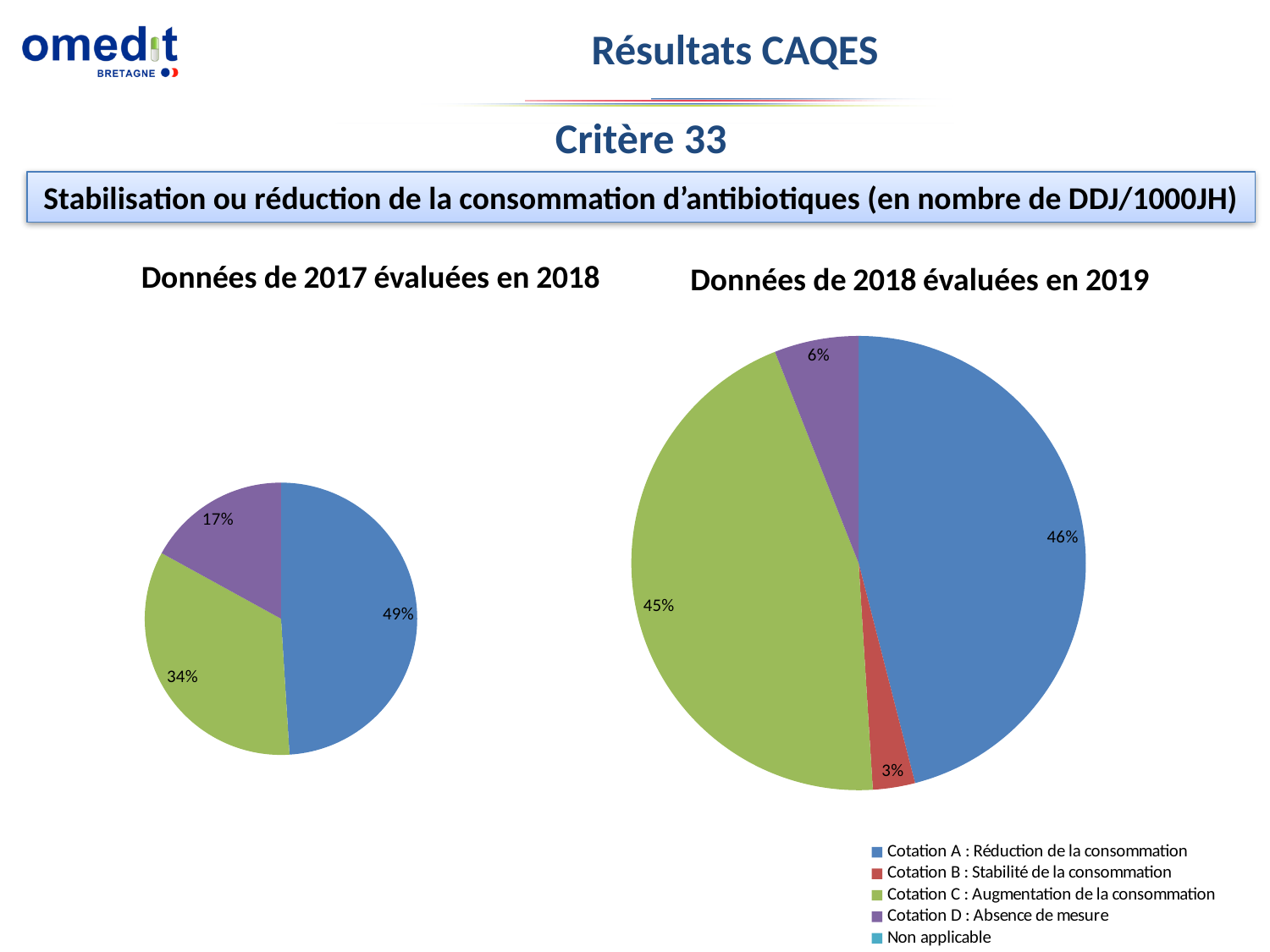
In the chart titled "Données de 2017 évaluées en 2018", what is the difference between the shares for Cotation A and Cotation C? 15% In the chart titled "Données de 2017 évaluées en 2018", which category has the smallest slice? Cotation D : Absence de mesure Which chart shows a larger share for Cotation D : Absence de mesure, the 2017 data chart or the 2018 data chart? Données de 2017 évaluées en 2018 In the chart titled "Données de 2017 évaluées en 2018", what share is shown for Cotation A : Réduction de la consommation? 49% How many entries does the legend list? 5 In the chart titled "Données de 2018 évaluées en 2019", what share is shown for Cotation C : Augmentation de la consommation? 45% In the chart titled "Données de 2018 évaluées en 2019", what share is shown for Cotation B : Stabilité de la consommation? 3% What type of chart is used on this slide? Pie chart In the chart titled "Données de 2018 évaluées en 2019", which category has the largest slice? Cotation A : Réduction de la consommation In the chart titled "Données de 2018 évaluées en 2019", which category has the smallest slice? Cotation B : Stabilité de la consommation How many slices does the chart titled "Données de 2018 évaluées en 2019" have? 4 In the chart titled "Données de 2017 évaluées en 2018", what share is shown for Cotation D : Absence de mesure? 17%